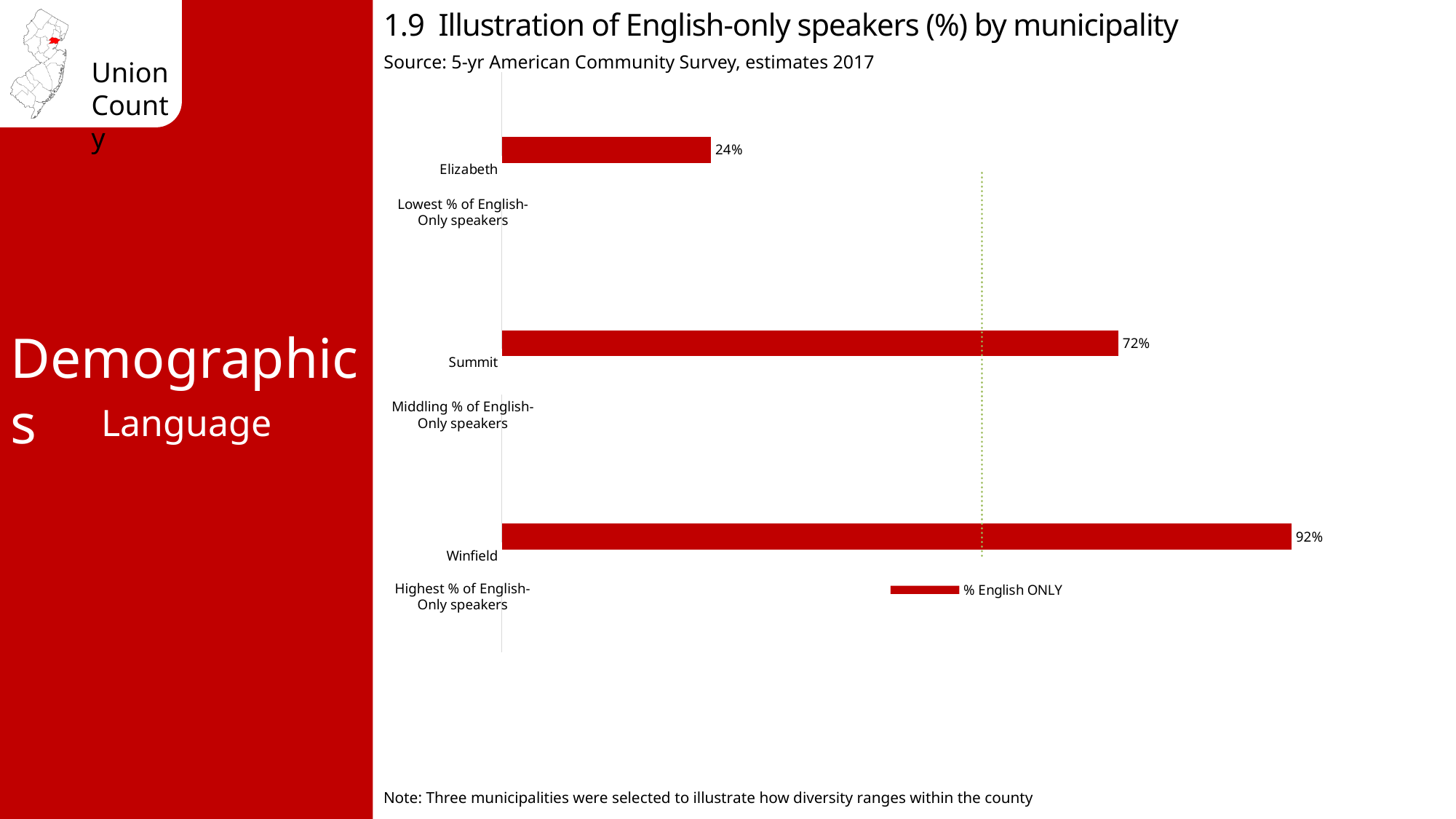
How many series does the legend list? 1 What is the value for Winfield? 92% What is the value for Summit? 72% Which municipality has the highest percentage of English-only speakers? Winfield Which municipality has the lowest percentage of English-only speakers? Elizabeth Which has a larger value, Summit or Elizabeth? Summit How many municipalities are shown in the chart? 3 What is the legend entry for the series in the chart? % English ONLY What is the difference between the values for Winfield and Elizabeth? 68% What kind of chart is shown on the slide? Bar chart What is the value for Elizabeth? 24% What is the difference between the values for Summit and Elizabeth? 48%